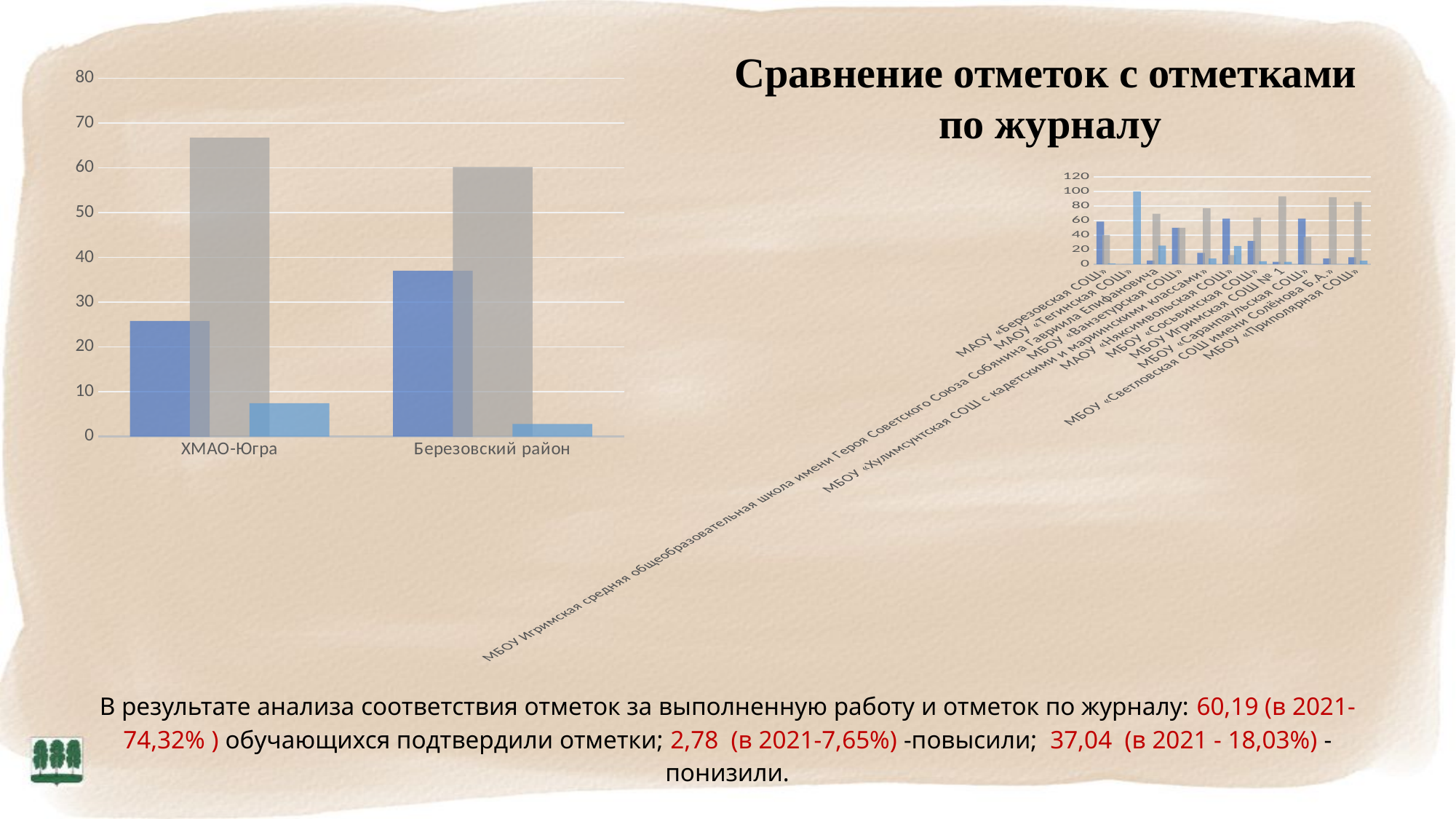
What is the highest value shown on the vertical axis of the left chart? 80 How many school categories are shown on the x axis of the small chart on the right? 11 In the left chart, is the dark blue bar for ХМАО-Югра greater or less than 30? less In the left chart, which category has the taller dark blue bar, ХМАО-Югра or Березовский район? Березовский район In the left chart, which category has the taller gray bar, ХМАО-Югра or Березовский район? ХМАО-Югра In the left chart, is the dark blue bar for Березовский район greater or less than 30? greater In the left chart, which category has the taller light blue bar, ХМАО-Югра or Березовский район? ХМАО-Югра In the left chart, is the light blue bar for ХМАО-Югра greater or less than 10? less How many categories are shown on the x axis of the left chart? 2 What is the highest value shown on the vertical axis of the small chart on the right? 120 What kind of chart is the chart on the left side of the slide? bar chart